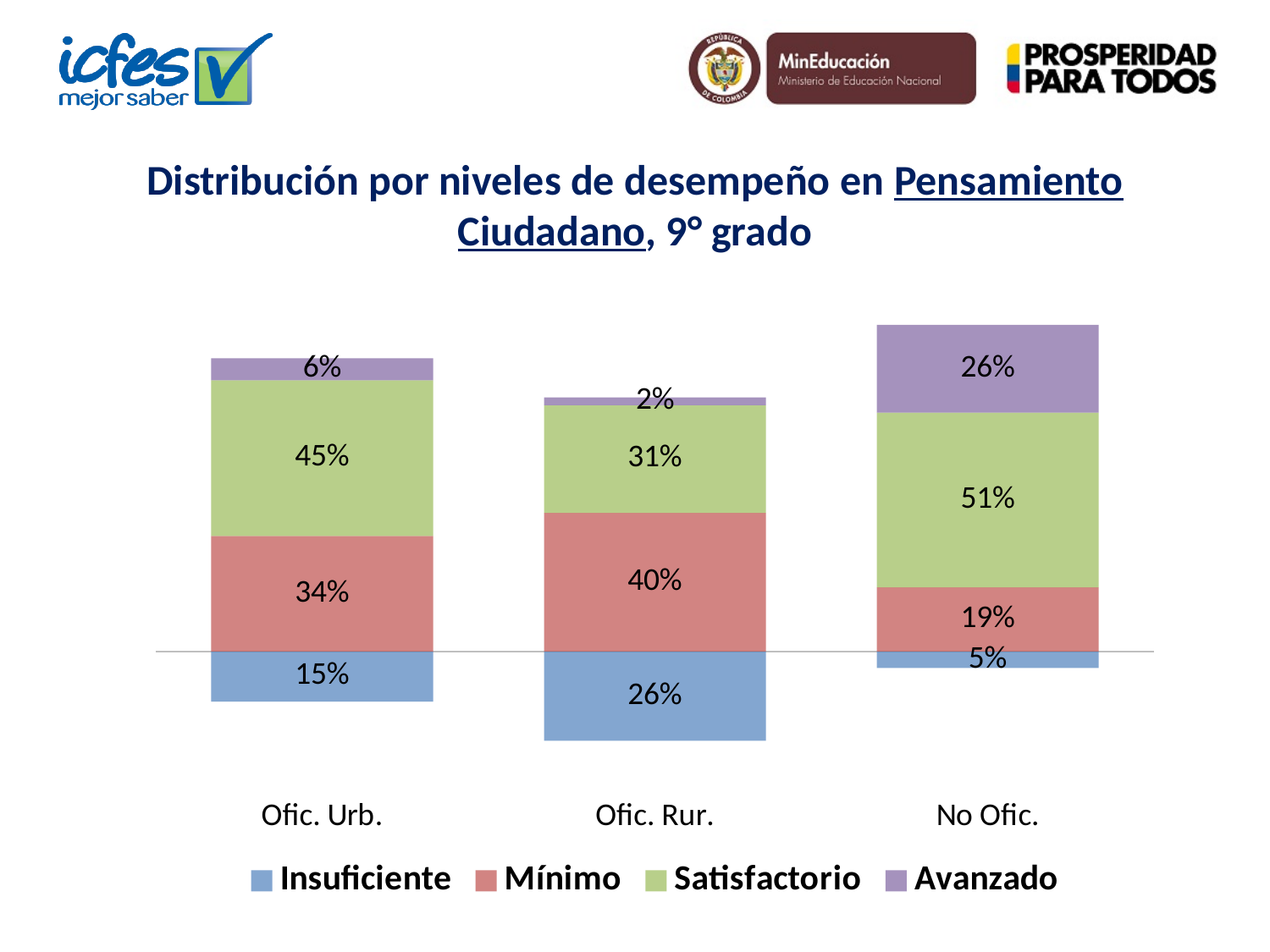
What kind of chart is shown on the slide? Stacked bar chart What is the Mínimo value for No Ofic.? 19% Which category has the lowest Insuficiente value? No Ofic. Which category has the highest Avanzado value? No Ofic. How many categories are shown on the x axis? 3 How many series does the legend list? 4 What is the Insuficiente value for Ofic. Rur.? 26% What is the total of the stacked bar for Ofic. Rur.? 99% What percentage of Ofic. Urb. students are at the Satisfactorio level? 45% Which is larger, the Satisfactorio value for Ofic. Urb. or for Ofic. Rur.? Ofic. Urb. What is the difference between the Mínimo values for Ofic. Rur. and Ofic. Urb.? 6% What is the Avanzado value for No Ofic.? 26%